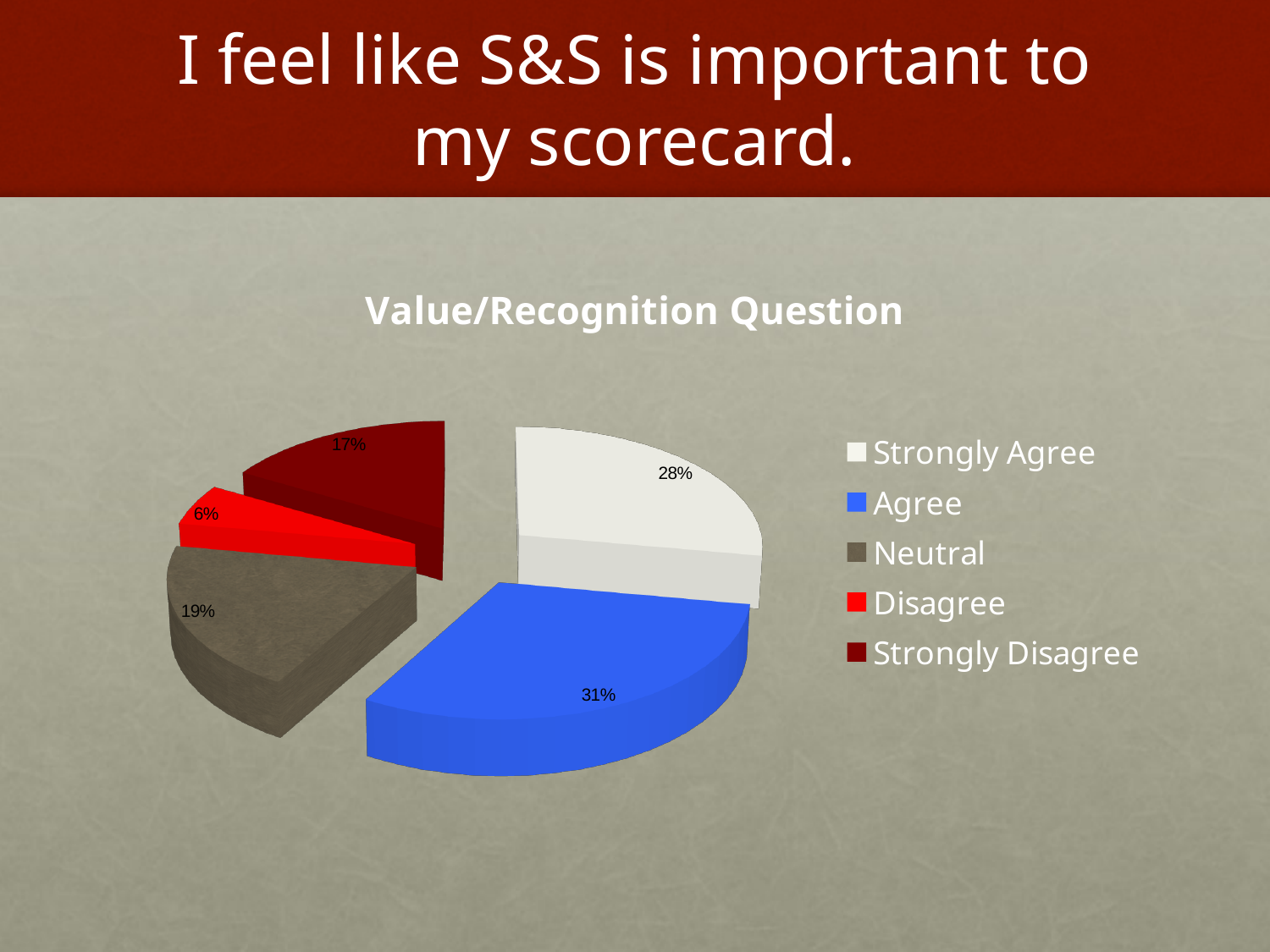
What kind of chart is shown on the slide? Pie chart Which response category has the largest share of the pie? Agree Which response category has the smallest share of the pie? Disagree What percentage of respondents chose Strongly Disagree? 17% What is the chart's title? Value/Recognition Question What percentage of respondents chose Agree? 31% How many categories does the legend list? 5 What percentage of respondents chose Disagree? 6% What is the difference in percentage points between Agree and Strongly Agree? 3 What percentage of respondents chose Strongly Agree? 28% Which is larger, the share for Neutral or the share for Strongly Disagree? Neutral What percentage of respondents chose Neutral? 19%